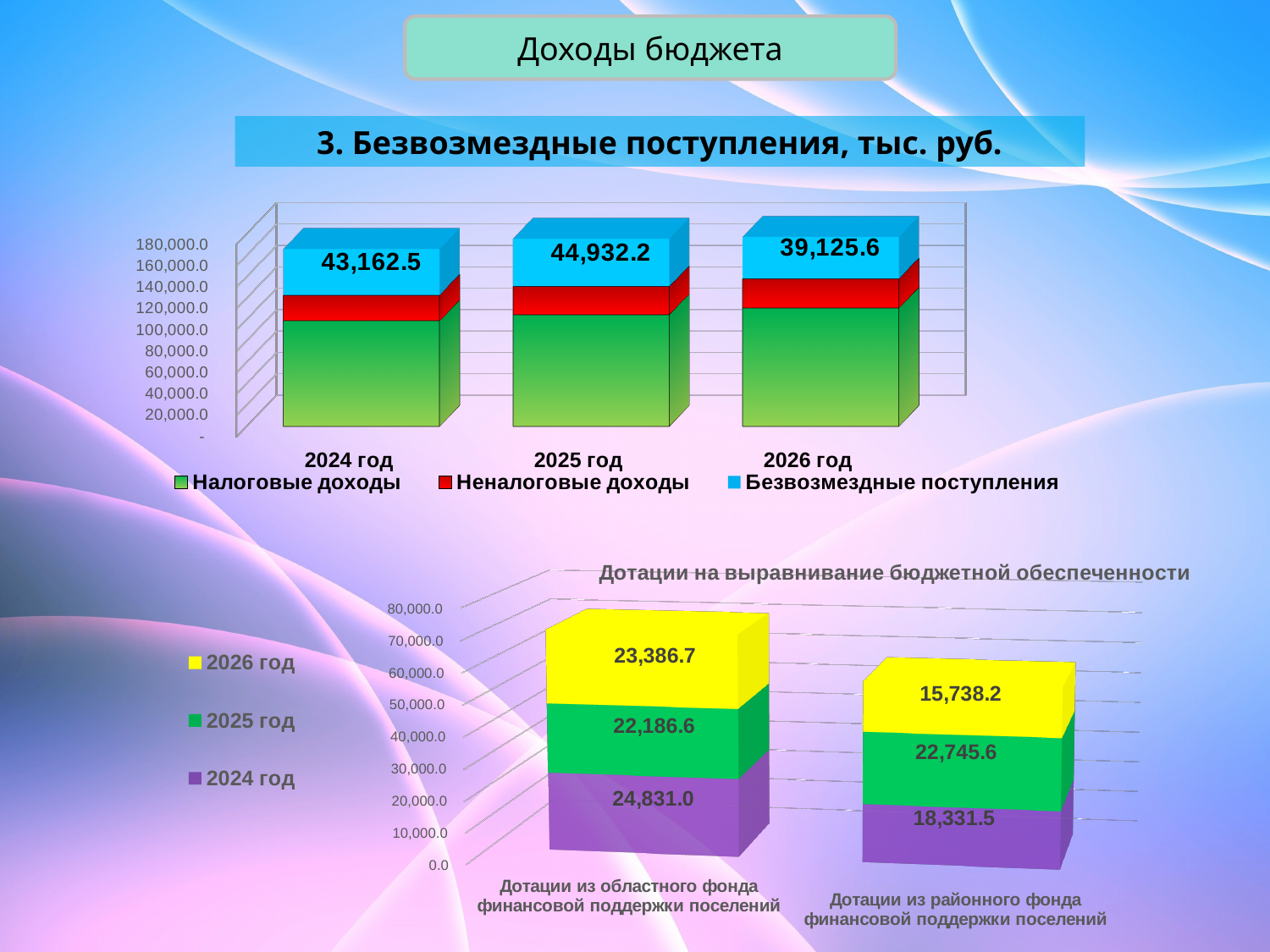
In the top chart, what is the value of Безвозмездные поступления for 2024 год? 43,162.5 What kind of chart is the bottom chart? Stacked bar chart In the top chart, how many series does the legend list? 3 In the chart 'Дотации на выравнивание бюджетной обеспеченности', which is larger: the 2024 год value for the областной фонд or for the районный фонд? Областной фонд In the top chart, what is the difference between the Безвозмездные поступления values for 2025 год and 2024 год? 1,769.7 In the chart 'Дотации на выравнивание бюджетной обеспеченности', what is the difference between the 2026 год values for the областной фонд and the районный фонд? 7,648.5 In the top chart, which colour represents Неналоговые доходы? Red In the chart 'Дотации на выравнивание бюджетной обеспеченности', what is the 2024 год value for Дотации из областного фонда финансовой поддержки поселений? 24,831.0 In the top chart, what is the value of Безвозмездные поступления for 2026 год? 39,125.6 In the chart 'Дотации на выравнивание бюджетной обеспеченности', what is the total of the stacked bar for Дотации из областного фонда финансовой поддержки поселений? 70,404.3 In the top chart, which year has the highest value of Безвозмездные поступления? 2025 год In the chart 'Дотации на выравнивание бюджетной обеспеченности', what is the 2025 год value for Дотации из районного фонда финансовой поддержки поселений? 22,745.6